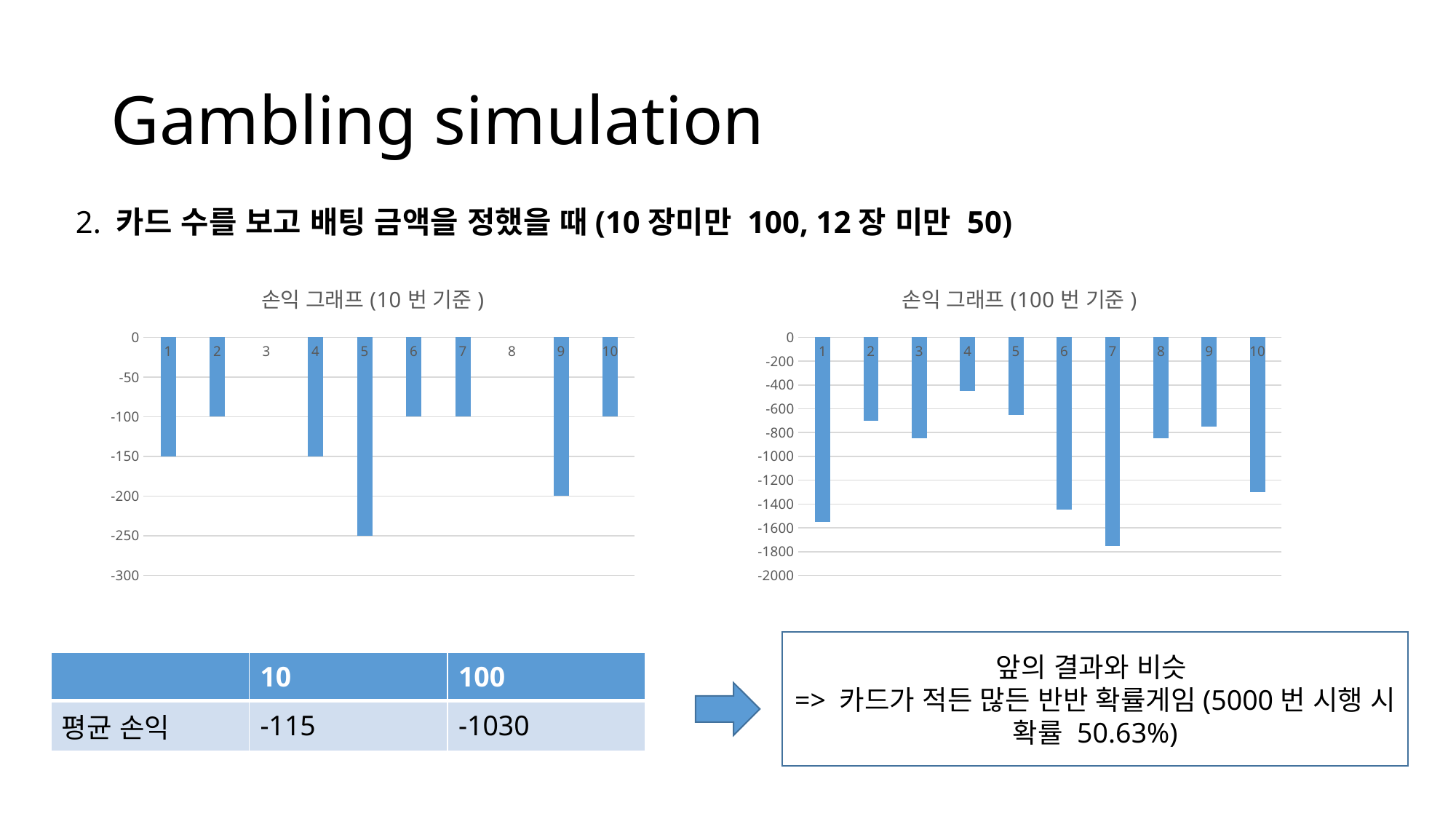
In the right chart (100 번 기준), is the value for category 1 greater or less than -1400? less In the left chart (10 번 기준), what is the difference between the values for category 5 and category 9? 50 In the right chart (100 번 기준), which category has the lowest value? 7 How many categories are shown on the x axis of the left chart (10 번 기준)? 10 In the right chart (100 번 기준), which category has the highest value? 4 What is the title of the right chart? 손익 그래프 (100 번 기준 ) In the left chart (10 번 기준), what is the value for category 5? -250 In the left chart (10 번 기준), which category has the lowest value? 5 In the left chart (10 번 기준), what is the value for category 9? -200 What type of chart is the left chart titled 손익 그래프 (10 번 기준 )? bar chart In the left chart (10 번 기준), which is larger, the value for category 1 or category 2? category 2 In the left chart (10 번 기준), what is the value for category 1? -150